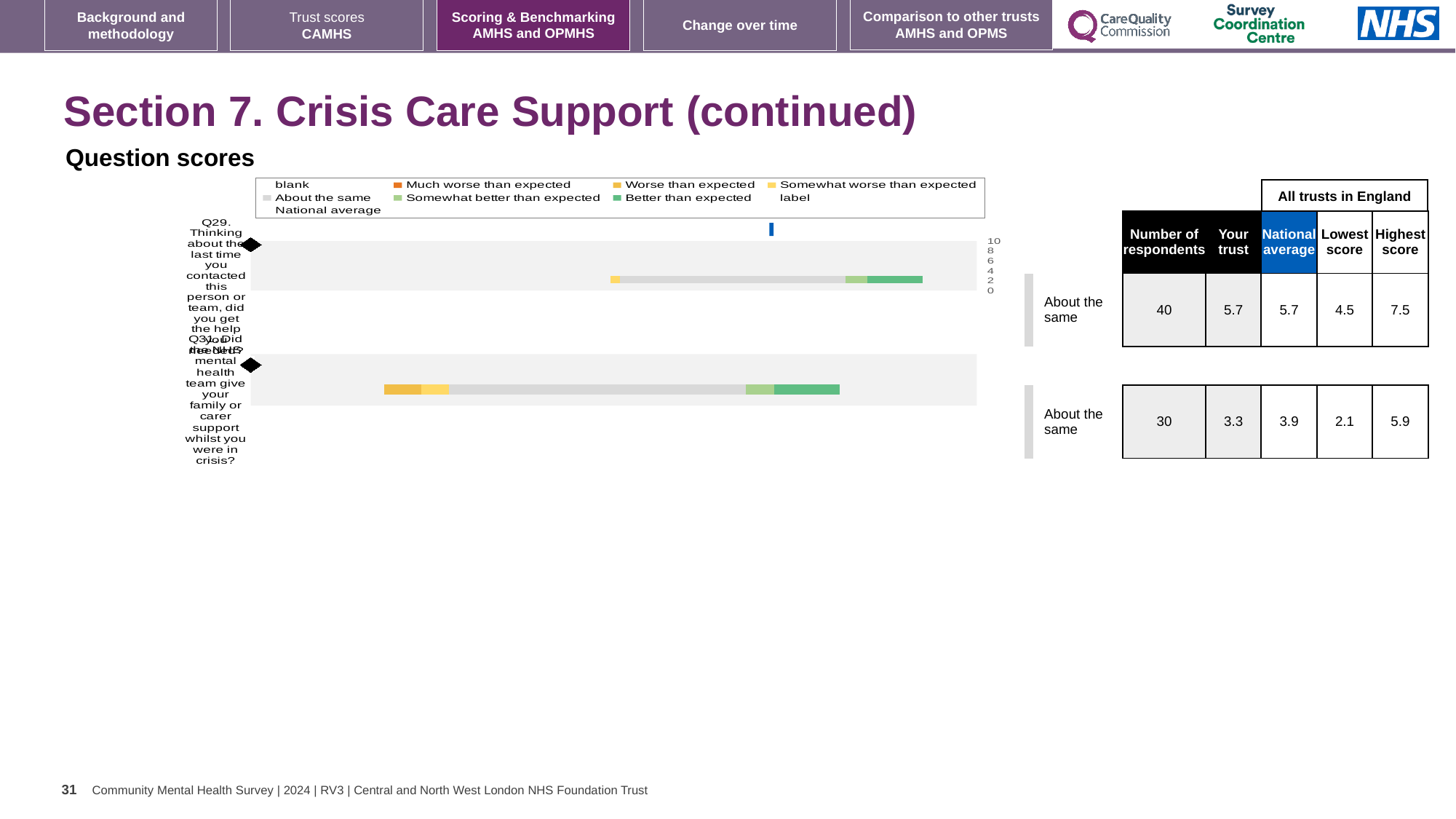
Which question has the larger number of respondents? Q29 What is the national average score for Q31? 3.9 Which question has the higher 'Your trust' score, Q29 or Q31? Q29 By how much does the national average exceed the 'Your trust' score for Q31? 0.6 How many questions (bars) are plotted in the question scores chart? 2 What is the difference between the highest and lowest scores for Q29? 3.0 How many respondents answered Q31 (did the NHS mental health team give your family or carer support whilst you were in crisis)? 30 What type of chart is used to show the question scores? bar chart What is the lowest score among all trusts in England for Q31? 2.1 What is the 'Your trust' score for Q29 (getting the help you needed the last time you contacted this person or team)? 5.7 How many entries does the legend of the question scores chart list? 9 What benchmark category is shown next to the bar for Q31? About the same